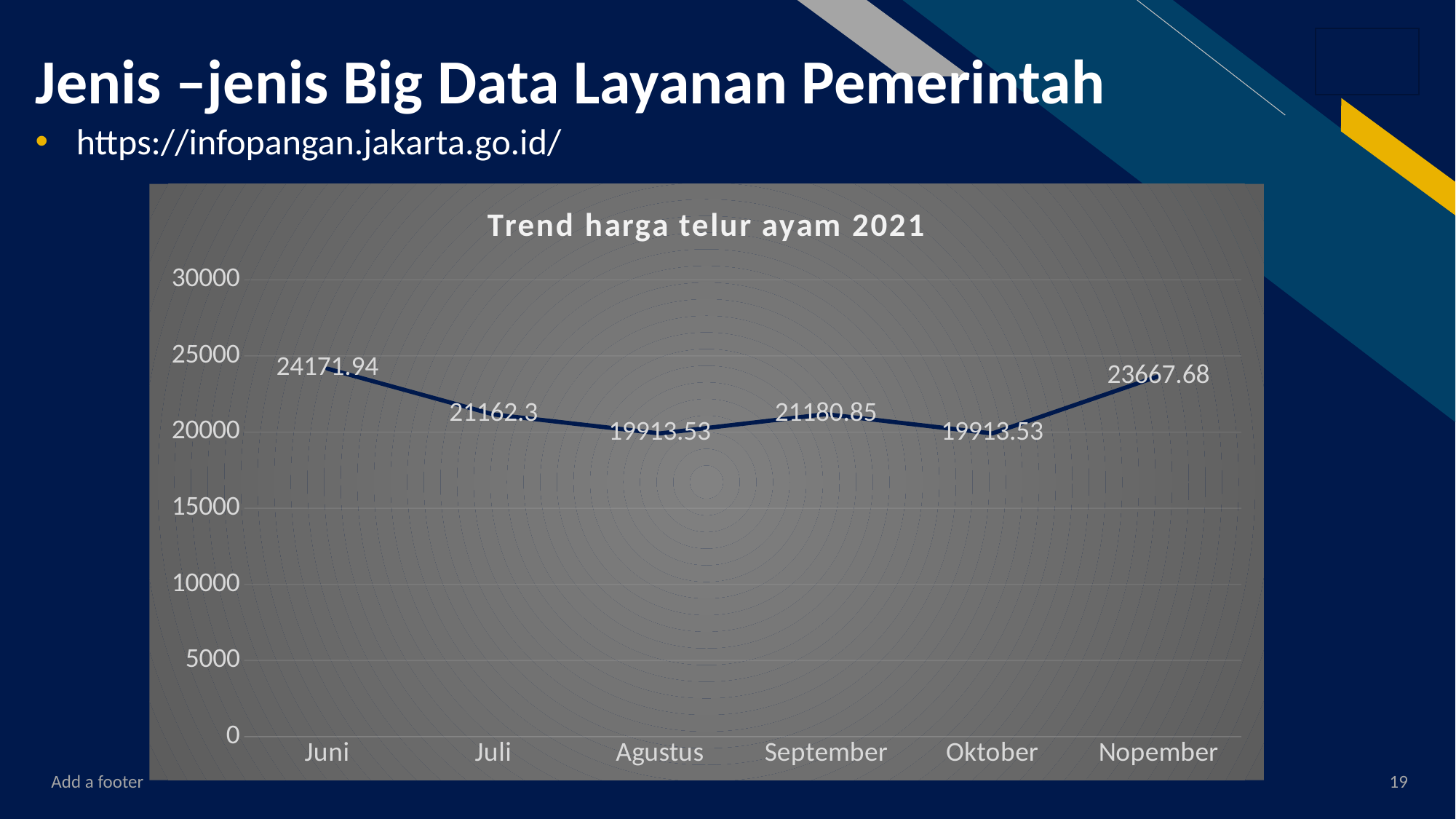
What is the difference between the values for Juni and Juli? 3009.64 What is the difference between the values for Juni and Nopember? 504.26 What is the value for September? 21180.85 What is the lowest value plotted on the chart? 19913.53 What kind of chart is shown on the slide? line chart Do the values rise or fall from Juni to Agustus? fall Which month has the highest value? Juni Which is larger, the value for Juni or the value for Agustus? Juni How many months are plotted on the x axis? 6 What is the value for Nopember? 23667.68 What is the value for Juni? 24171.94 What is the title of the chart? Trend harga telur ayam 2021